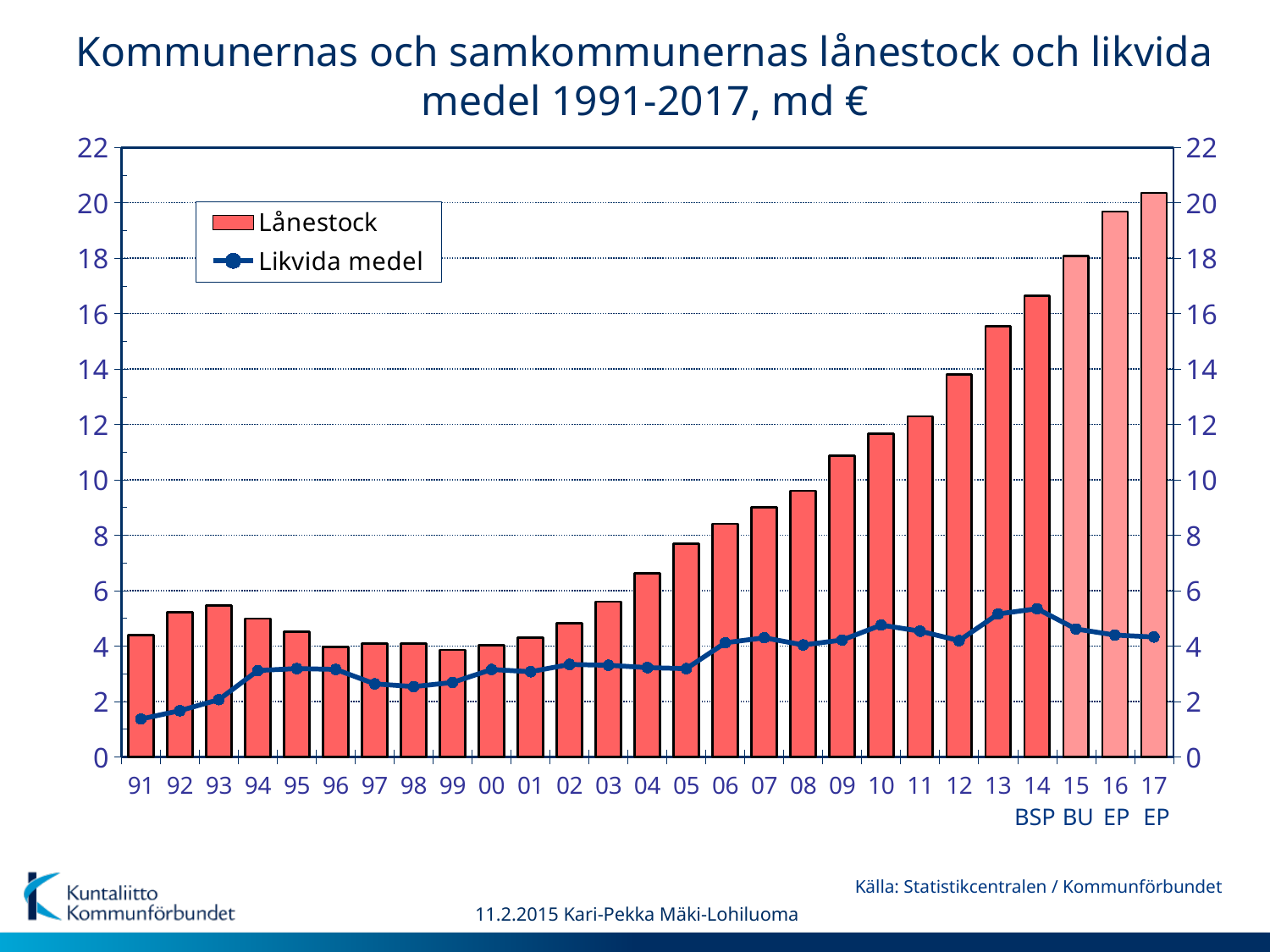
Is the Lånestock value for 05 greater or less than 8? less How many series does the legend list? 2 Which series is drawn as a line with markers? Likvida medel What kind of chart is shown on the slide? A combined bar and line chart Which is larger, the Lånestock bar for 93 or for 96? 93 Is the Lånestock value for 17 greater or less than 20? greater Is the Lånestock value for 09 greater or less than 10? greater Which year has the highest Lånestock bar? 17 Does the Lånestock series rise or fall from 05 to 17? rise Which year has the lowest Lånestock bar? 99 How many years are shown on the x axis? 27